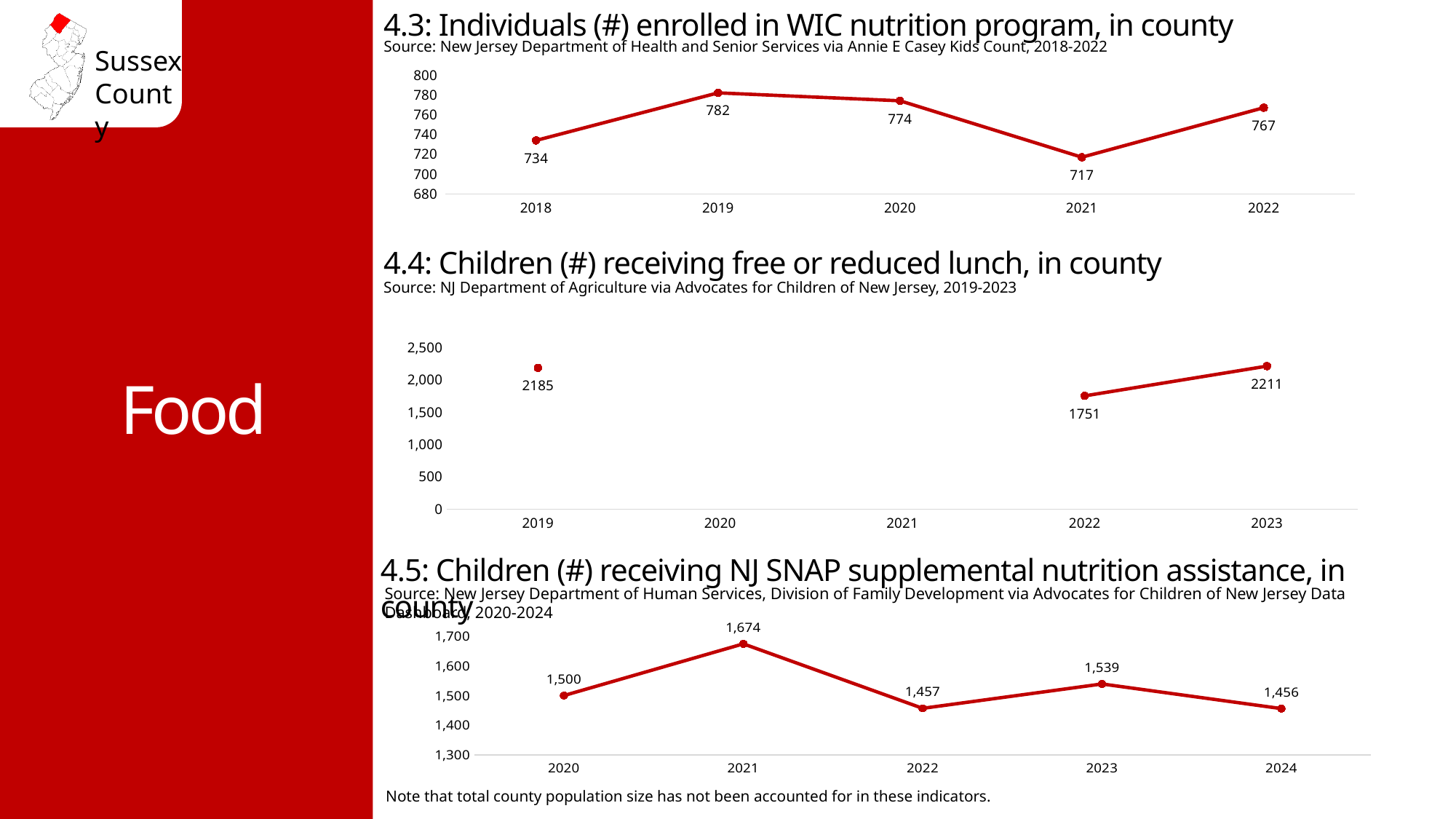
In the chart '4.4: Children (#) receiving free or reduced lunch, in county', is the value for 2019 greater or less than 2,000? greater In the chart '4.4: Children (#) receiving free or reduced lunch, in county', which year has the highest value? 2023 In the chart '4.5: Children (#) receiving NJ SNAP supplemental nutrition assistance, in county', which year has the highest value? 2021 In the chart '4.5: Children (#) receiving NJ SNAP supplemental nutrition assistance, in county', which is larger, the value for 2020 or the value for 2023? 2023 In the chart '4.5: Children (#) receiving NJ SNAP supplemental nutrition assistance, in county', what is the value for 2021? 1,674 In the chart '4.3: Individuals (#) enrolled in WIC nutrition program, in county', which year has the lowest value? 2021 In the chart '4.3: Individuals (#) enrolled in WIC nutrition program, in county', what is the value for 2019? 782 In the chart '4.3: Individuals (#) enrolled in WIC nutrition program, in county', how many years are plotted? 5 In the chart '4.5: Children (#) receiving NJ SNAP supplemental nutrition assistance, in county', what is the difference between the 2021 and 2022 values? 217 What type of chart is '4.3: Individuals (#) enrolled in WIC nutrition program, in county'? Line chart In the chart '4.4: Children (#) receiving free or reduced lunch, in county', what is the value for 2022? 1751 In the chart '4.3: Individuals (#) enrolled in WIC nutrition program, in county', what is the difference between the 2019 and 2021 values? 65